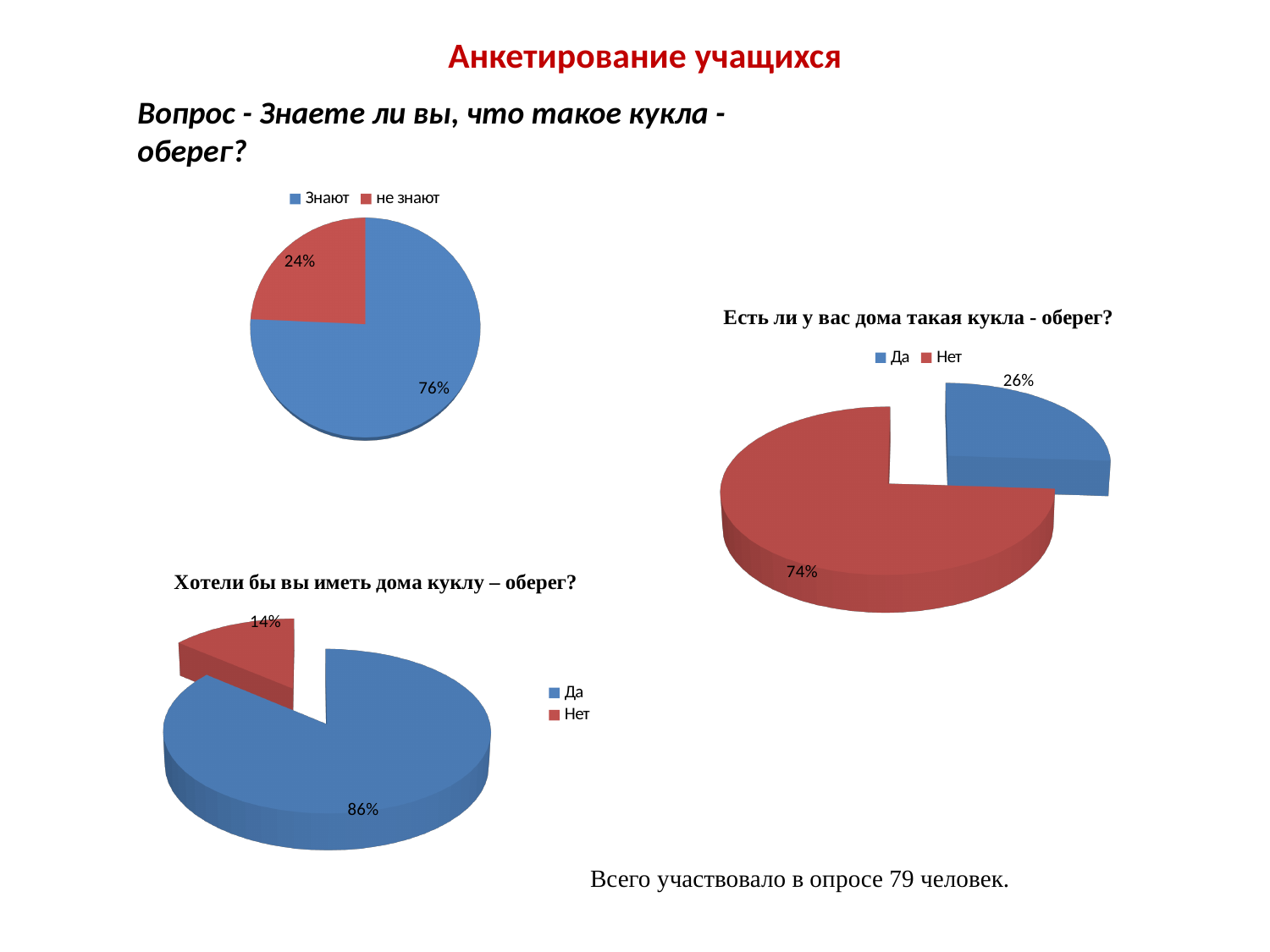
In the top-left pie chart (Знаете ли вы, что такое кукла-оберег?), what share is labelled for 'не знают'? 24% In the chart titled 'Хотели бы вы иметь дома куклу – оберег?', what percentage answered 'Да'? 86% In the chart titled 'Есть ли у вас дома такая кукла - оберег?', which is larger, 'Да' or 'Нет'? Нет In the top-left pie chart (Знаете ли вы, что такое кукла-оберег?), what share is labelled for 'Знают'? 76% In the chart titled 'Есть ли у вас дома такая кукла - оберег?', what percentage answered 'Да'? 26% In the top-left pie chart (Знаете ли вы, что такое кукла-оберег?), what is the difference in percentage points between 'Знают' and 'не знают'? 52 How many entries does the legend of the top-left pie chart (Знаете ли вы, что такое кукла-оберег?) list? 2 What type of chart is used for 'Хотели бы вы иметь дома куклу – оберег?'? Pie chart In the chart titled 'Есть ли у вас дома такая кукла - оберег?', what percentage answered 'Нет'? 74% In the chart titled 'Есть ли у вас дома такая кукла - оберег?', which answer has the smallest slice? Да In the chart titled 'Хотели бы вы иметь дома куклу – оберег?', which answer has the largest slice? Да In the chart titled 'Хотели бы вы иметь дома куклу – оберег?', what percentage answered 'Нет'? 14%